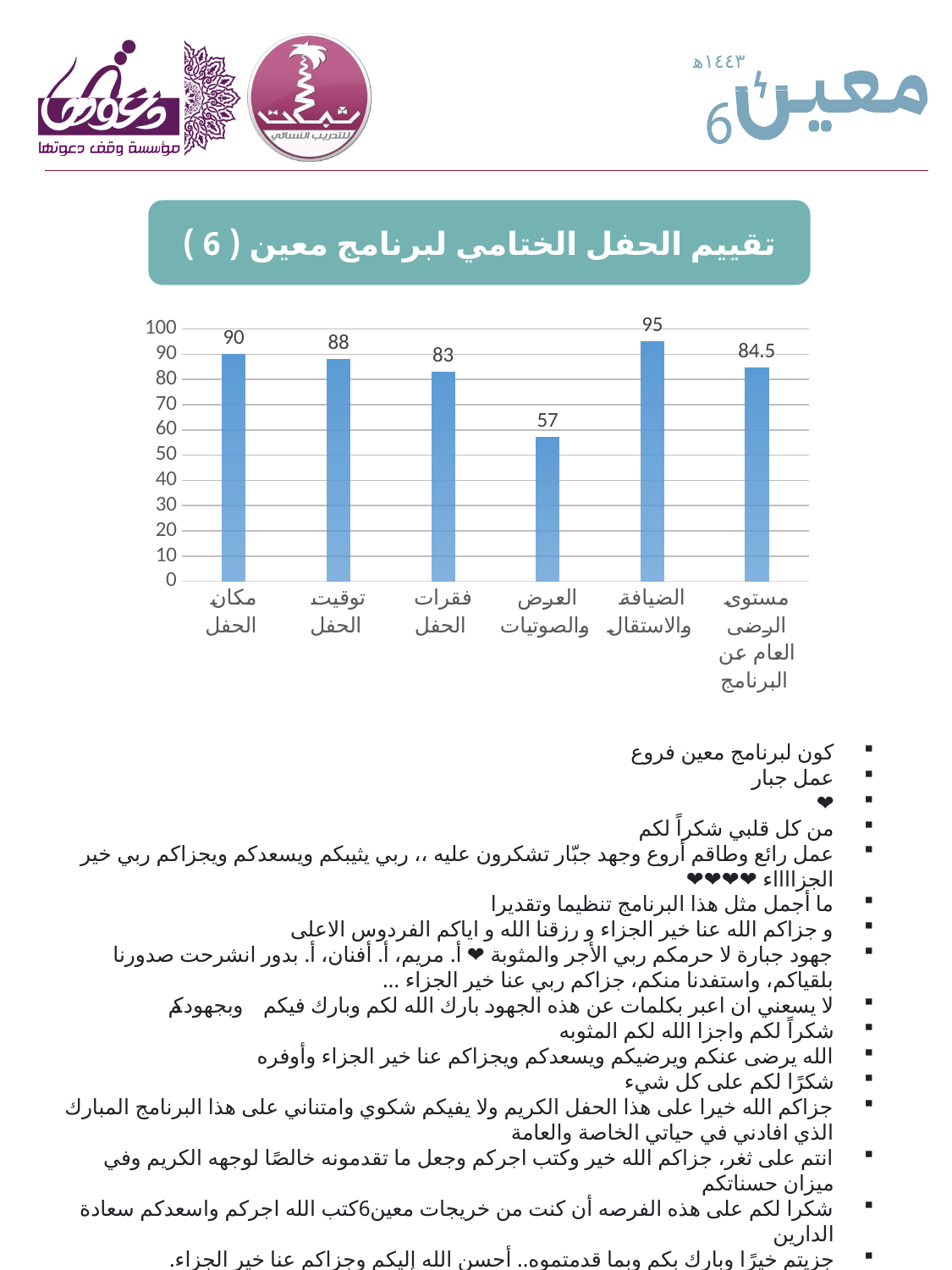
Which category has the highest value? الضيافة والاستقال What is the title of the chart? تقييم الحفل الختامي لبرنامج معين ( 6 ) Is the value for العرض والصوتيات greater or less than 60? less What kind of chart is shown on the slide? bar chart Which category has the lowest value? العرض والصوتيات What is the difference between the values for الضيافة والاستقبال and العرض والصوتيات? 38 How many categories are shown in the chart? 6 What is the value for مستوى الرضى العام عن البرنامج? 84.5 Which is larger, the value for توقيت الحفل or the value for فقرات الحفل? توقيت الحفل What is the value for العرض والصوتيات? 57 What is the difference between the values for مكان الحفل and توقيت الحفل? 2 What is the value for مكان الحفل? 90